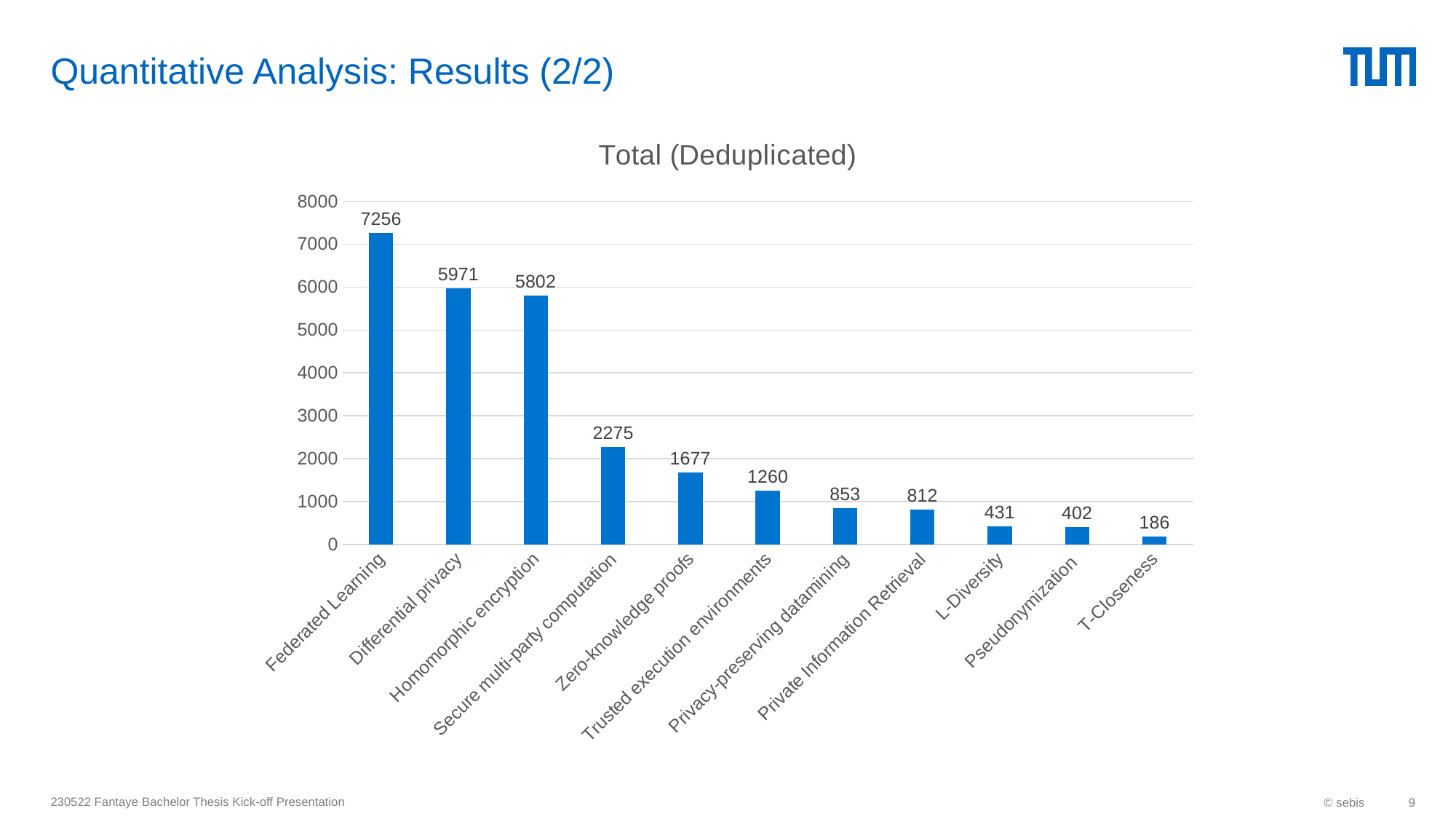
What kind of chart is shown on the slide? bar chart What is the value for Federated Learning? 7256 Is the value for L-Diversity greater or less than 1000? less What is the difference between the values for Differential privacy and Homomorphic encryption? 169 Which category has the lowest value? T-Closeness What is the difference between the values for Zero-knowledge proofs and Trusted execution environments? 417 What is the value for Secure multi-party computation? 2275 What is the value for Pseudonymization? 402 What is the title of the chart? Total (Deduplicated) Which is larger, the value for Privacy-preserving datamining or the value for Private Information Retrieval? Privacy-preserving datamining How many categories are shown on the x axis? 11 Which category has the highest value? Federated Learning